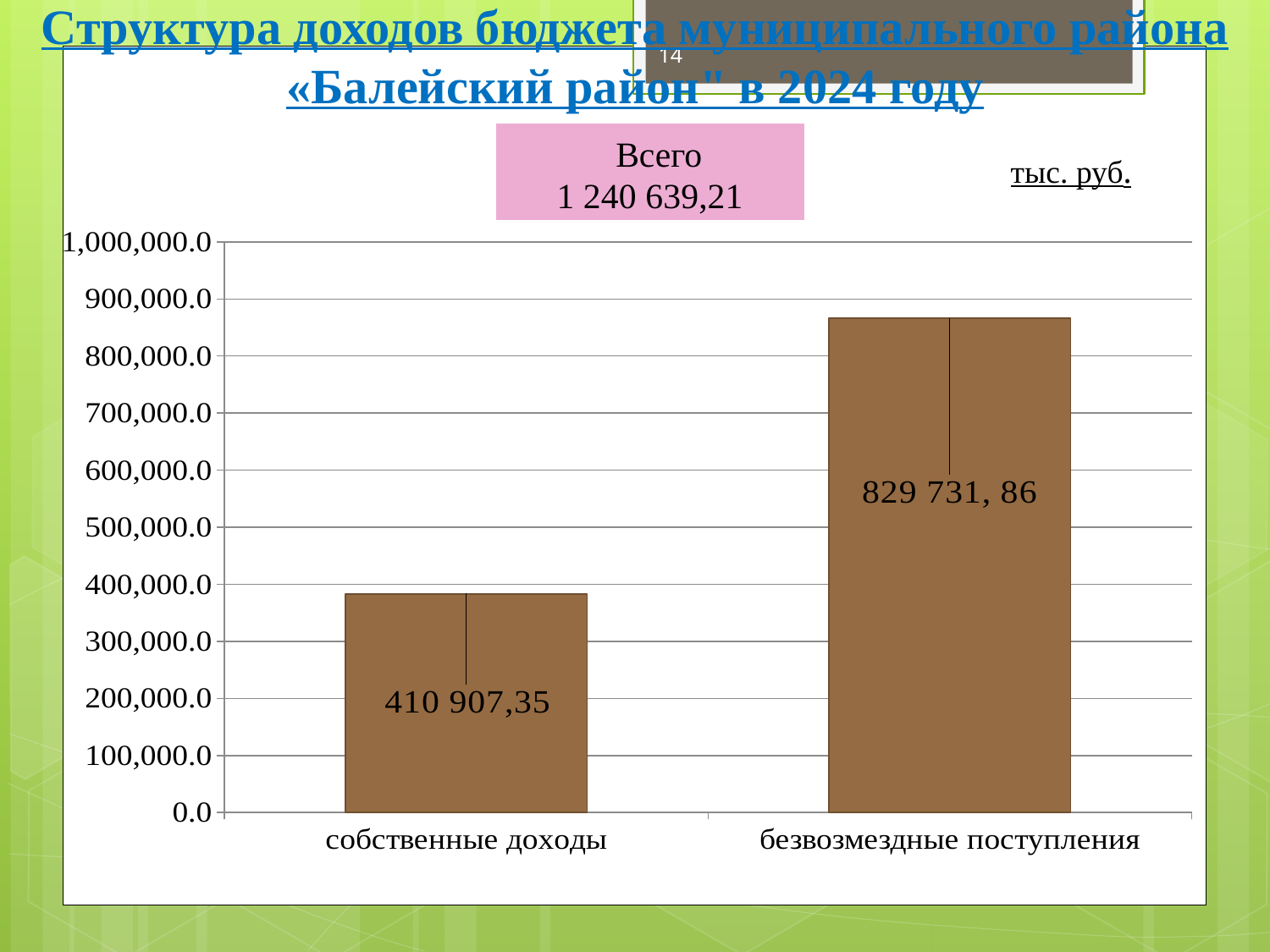
What total ("Всего") is shown above the chart? 1 240 639,21 Which category has the highest value? безвозмездные поступления What is the difference between the values for "безвозмездные поступления" and "собственные доходы"? 418 824,51 Is the value for "собственные доходы" greater or less than 500,000.0? less What type of chart is shown on the slide? bar chart Which is larger: "собственные доходы" or "безвозмездные поступления"? безвозмездные поступления What is the value shown for "собственные доходы"? 410 907,35 What is the value shown for "безвозмездные поступления"? 829 731, 86 Which category has the lowest value? собственные доходы How many categories are plotted in the chart? 2 Is the value for "безвозмездные поступления" greater or less than 800,000.0? greater What unit of measurement is indicated on the slide for the chart values? тыс. руб.